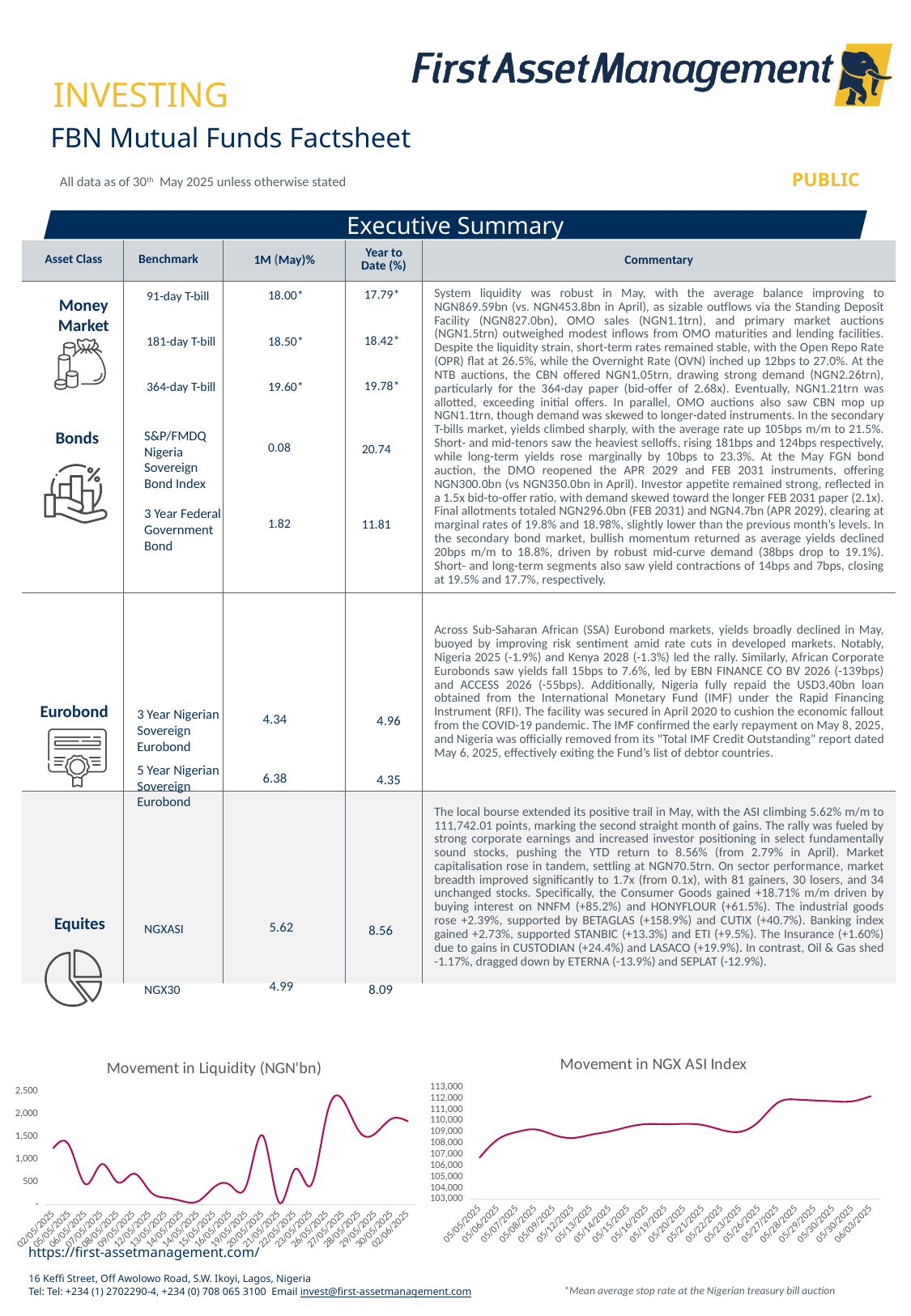
What kind of chart is the 'Movement in Liquidity (NGN'bn)' chart? line chart In the 'Movement in NGX ASI Index' chart, does the index generally rise or fall from 05/05/2025 to 06/03/2025? rise In the 'Movement in Liquidity (NGN'bn)' chart, is the value on 14/05/2025 greater or less than 500? less In the 'Movement in NGX ASI Index' chart, is the value on 06/03/2025 greater or less than 111,000? greater In the 'Movement in Liquidity (NGN'bn)' chart, which date has the larger value, 02/05/2025 or 14/05/2025? 02/05/2025 What is the title of the chart on the bottom right of the slide? Movement in NGX ASI Index In the 'Movement in Liquidity (NGN'bn)' chart, is the value on 27/05/2025 greater or less than 2,000? greater What kind of chart is the 'Movement in NGX ASI Index' chart? line chart In the 'Movement in NGX ASI Index' chart, on which date is the index at its lowest? 05/05/2025 In the 'Movement in Liquidity (NGN'bn)' chart, on which date does liquidity reach its highest point? 27/05/2025